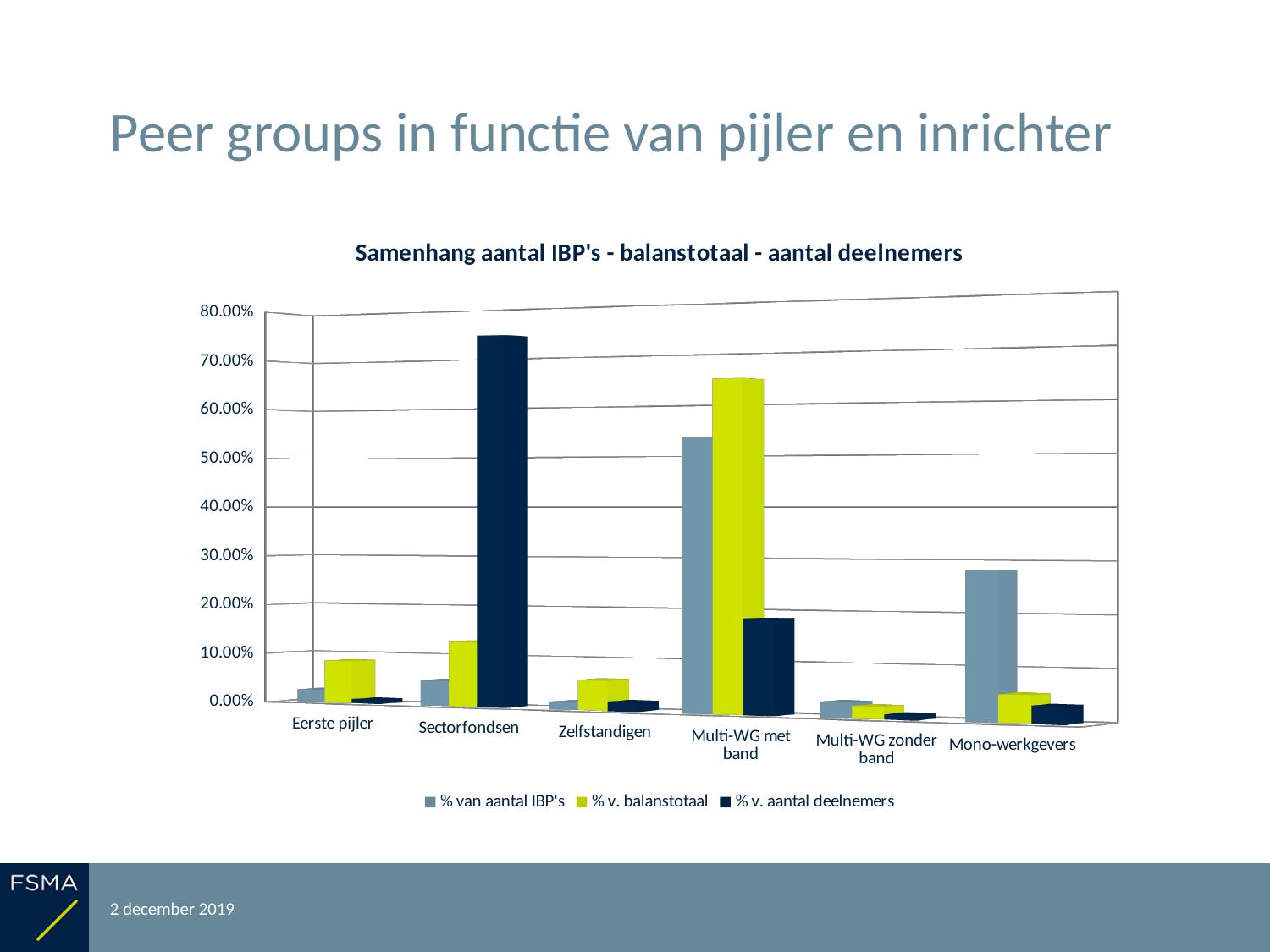
For Multi-WG met band, which is larger: '% van aantal IBP's' or '% v. balanstotaal'? % v. balanstotaal For Mono-werkgevers, which is larger: '% van aantal IBP's' or '% v. balanstotaal'? % van aantal IBP's What kind of chart is shown on the slide? Bar chart Is the '% v. aantal deelnemers' value for Sectorfondsen greater or less than 70.00%? greater Is the '% van aantal IBP's' value for Mono-werkgevers greater or less than 20.00%? greater Which category has the highest value for '% v. aantal deelnemers'? Sectorfondsen How many series does the chart's legend list? 3 What is the title of the chart? Samenhang aantal IBP's - balanstotaal - aantal deelnemers Which category has the highest value for '% v. balanstotaal'? Multi-WG met band Which category has the highest value for '% van aantal IBP's'? Multi-WG met band How many categories are shown on the x axis of the chart? 6 Is the '% v. balanstotaal' value for Multi-WG met band greater or less than 60.00%? greater